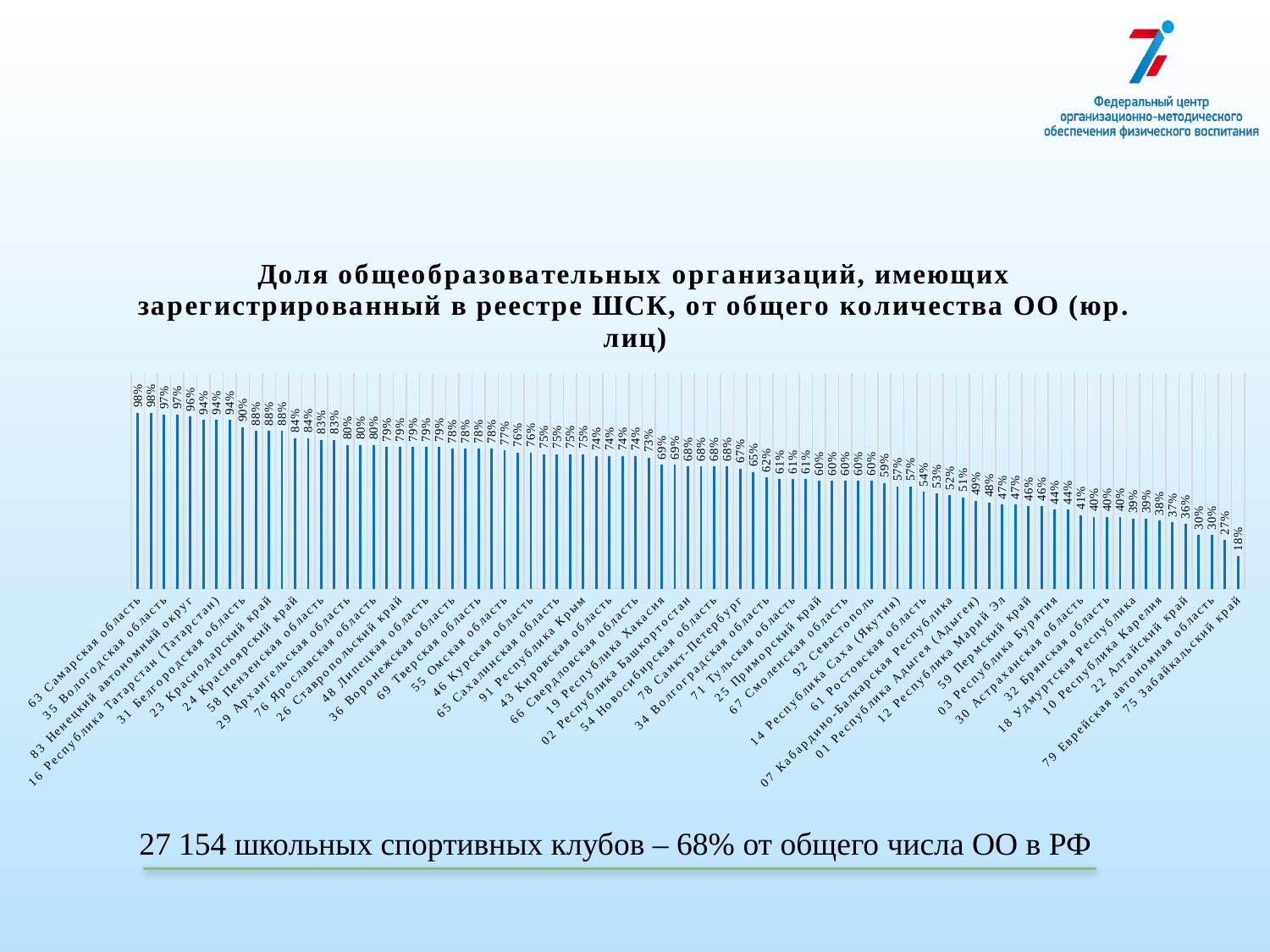
Do the values rise or fall from left to right along the x axis? fall What is the difference between the highest value (98%) and the lowest value (18%) in the chart? 80 percentage points What type of chart is shown on the slide? bar chart What is the title of the chart? Доля общеобразовательных организаций, имеющих зарегистрированный в реестре ШСК, от общего количества ОО (юр. лиц) What is the value shown for 63 Самарская область? 98% Which region has the lowest share of general education organisations with a registered school sports club? 75 Забайкальский край What is the value shown for 75 Забайкальский край? 18% Which has a larger value: 63 Самарская область or 75 Забайкальский край? 63 Самарская область According to the text below the chart, what share of the total number of ОО in the RF do the 27 154 school sports clubs represent? 68%